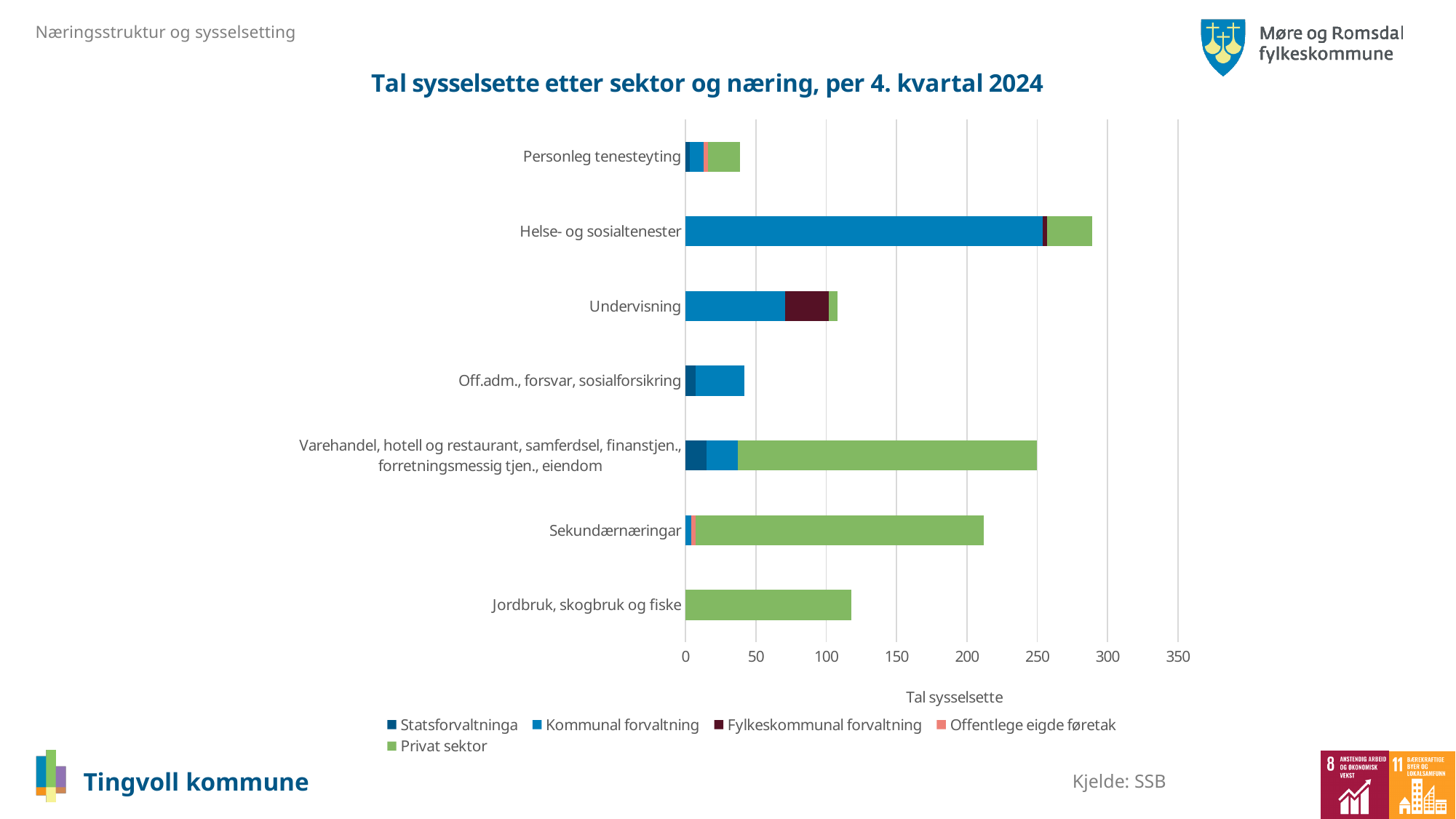
What kind of chart is shown on the slide? Stacked bar chart Which has the larger total bar: Helse- og sosialtenester or Varehandel, hotell og restaurant, samferdsel, finanstjen., forretningsmessig tjen., eiendom? Helse- og sosialtenester What is the title of the chart? Tal sysselsette etter sektor og næring, per 4. kvartal 2024 Which category has the longest total bar? Helse- og sosialtenester Is the total value for Off.adm., forsvar, sosialforsikring greater or less than 50? less Is the total value for Jordbruk, skogbruk og fiske greater or less than 100? greater Is the total value for Sekundærnæringar greater or less than 200? greater Which has the larger total bar: Sekundærnæringar or Jordbruk, skogbruk og fiske? Sekundærnæringar How many categories (næringar) are shown on the y axis of the chart? 7 How many series does the legend list? 5 Which series is shown in green in the legend? Privat sektor